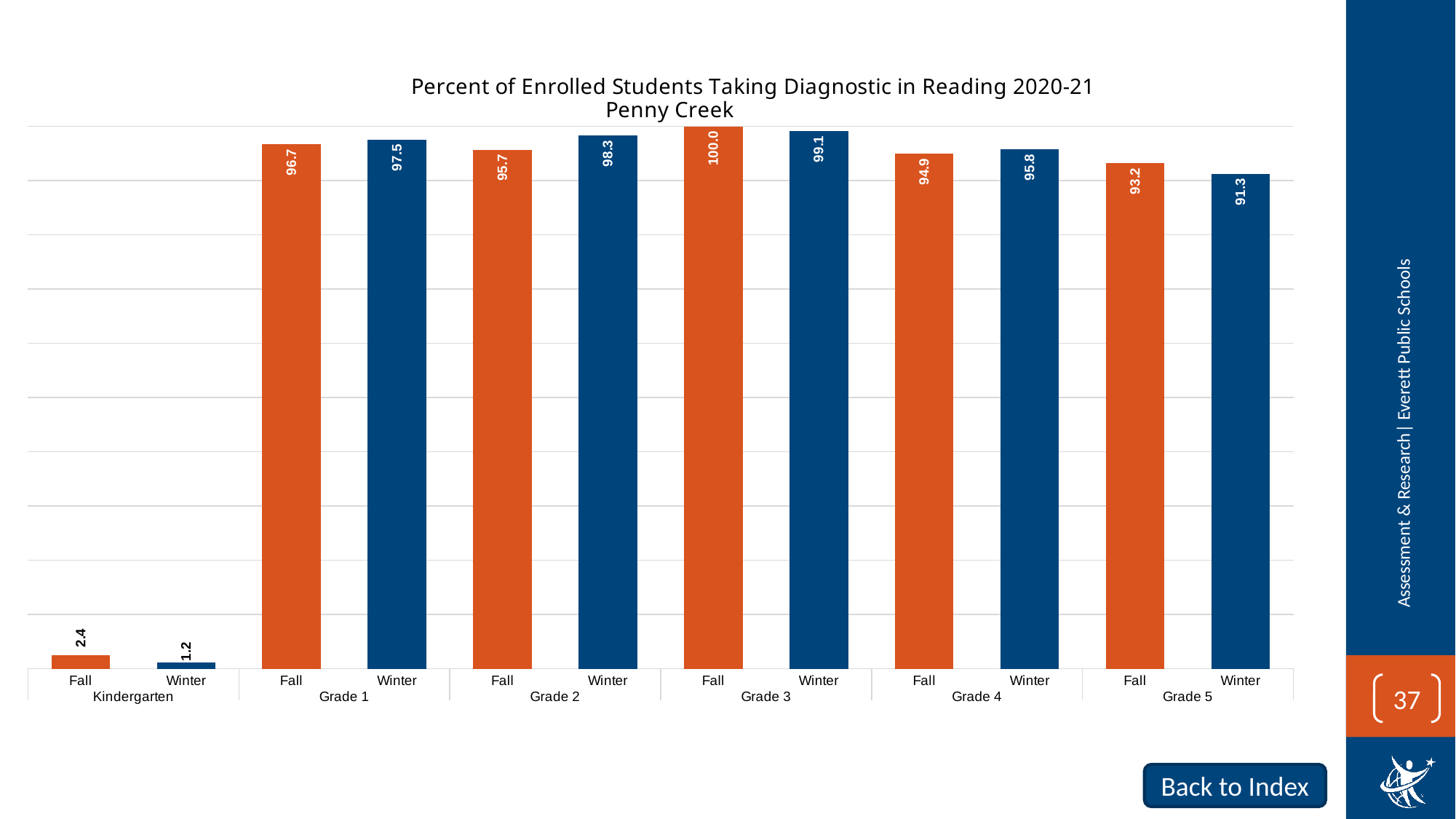
What is the difference between the Winter value for Grade 2 and the Winter value for Grade 1? 0.8 How many grade levels are shown on the x axis? 6 What is the Winter value for Grade 2? 98.3 What school is named in the chart title? Penny Creek Which bar has the lowest value on the chart? Kindergarten Winter What is the Fall value for Grade 5? 93.2 What is the Fall value for Grade 3? 100.0 What is the difference between the Fall and Winter values for Grade 5? 1.9 Which is larger, the Fall value for Grade 1 or the Fall value for Grade 2? Fall value for Grade 1 What is the Winter value for Kindergarten? 1.2 Which bar has the highest value on the chart? Grade 3 Fall What kind of chart is shown on the slide? Bar chart